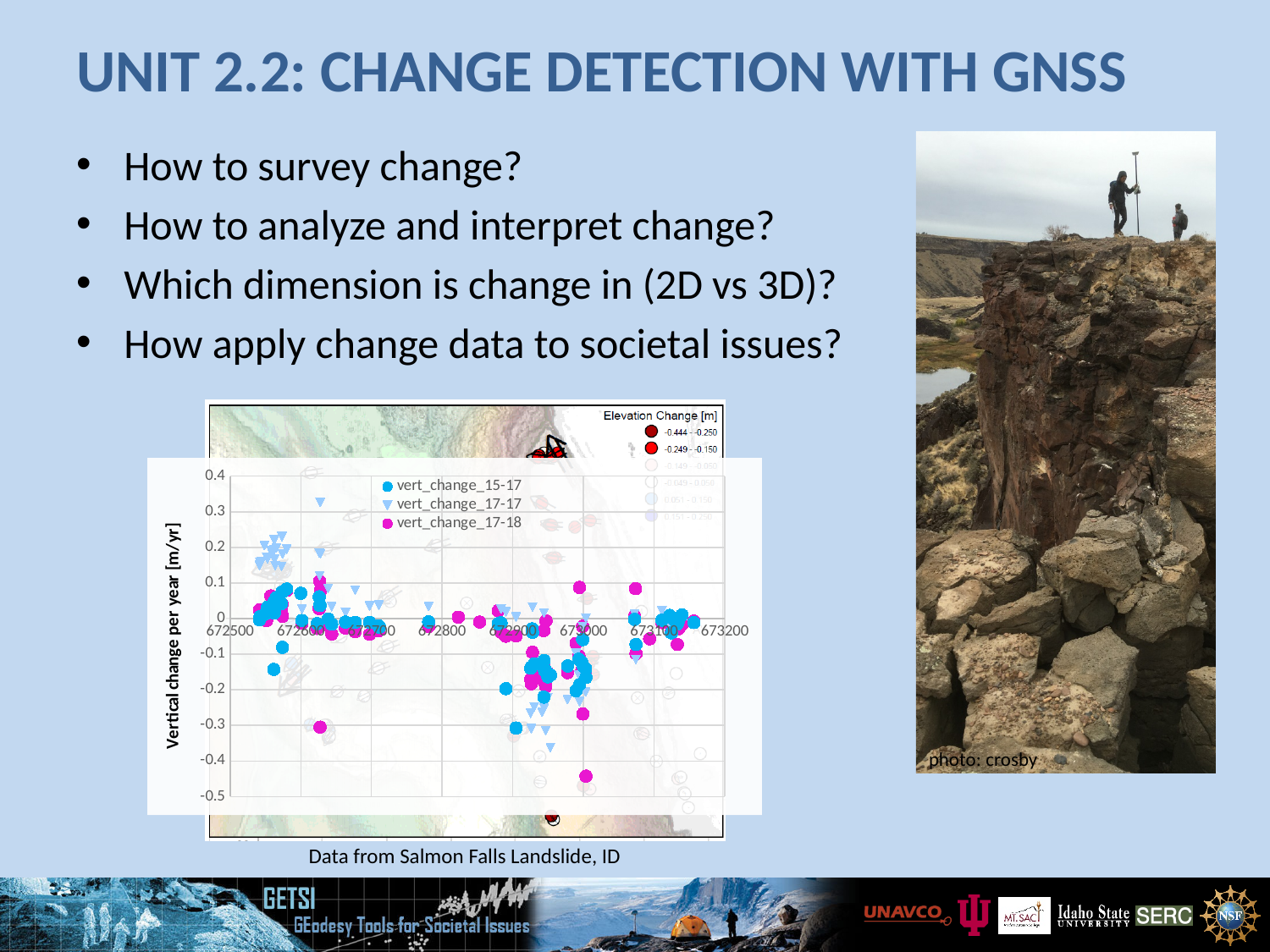
What is the lowest value shown on the chart's vertical axis? -0.5 Which series is listed first in the chart legend? vert_change_15-17 What kind of chart is shown on the slide? scatter chart What is the first tick value shown on the chart's horizontal axis? 672500 Is the highest plotted value for vert_change_17-17 greater or less than 0.2? greater Is the lowest plotted value for vert_change_15-17 greater or less than -0.2? less What caption appears below the chart describing the data source? Data from Salmon Falls Landslide, ID What is the highest value shown on the chart's vertical axis? 0.4 What is the last tick value shown on the chart's horizontal axis? 673200 Is the lowest plotted value for vert_change_17-18 greater or less than -0.4? less What is the title of the vertical axis of the chart? Vertical change per year [m/yr] How many series does the chart legend list? 3